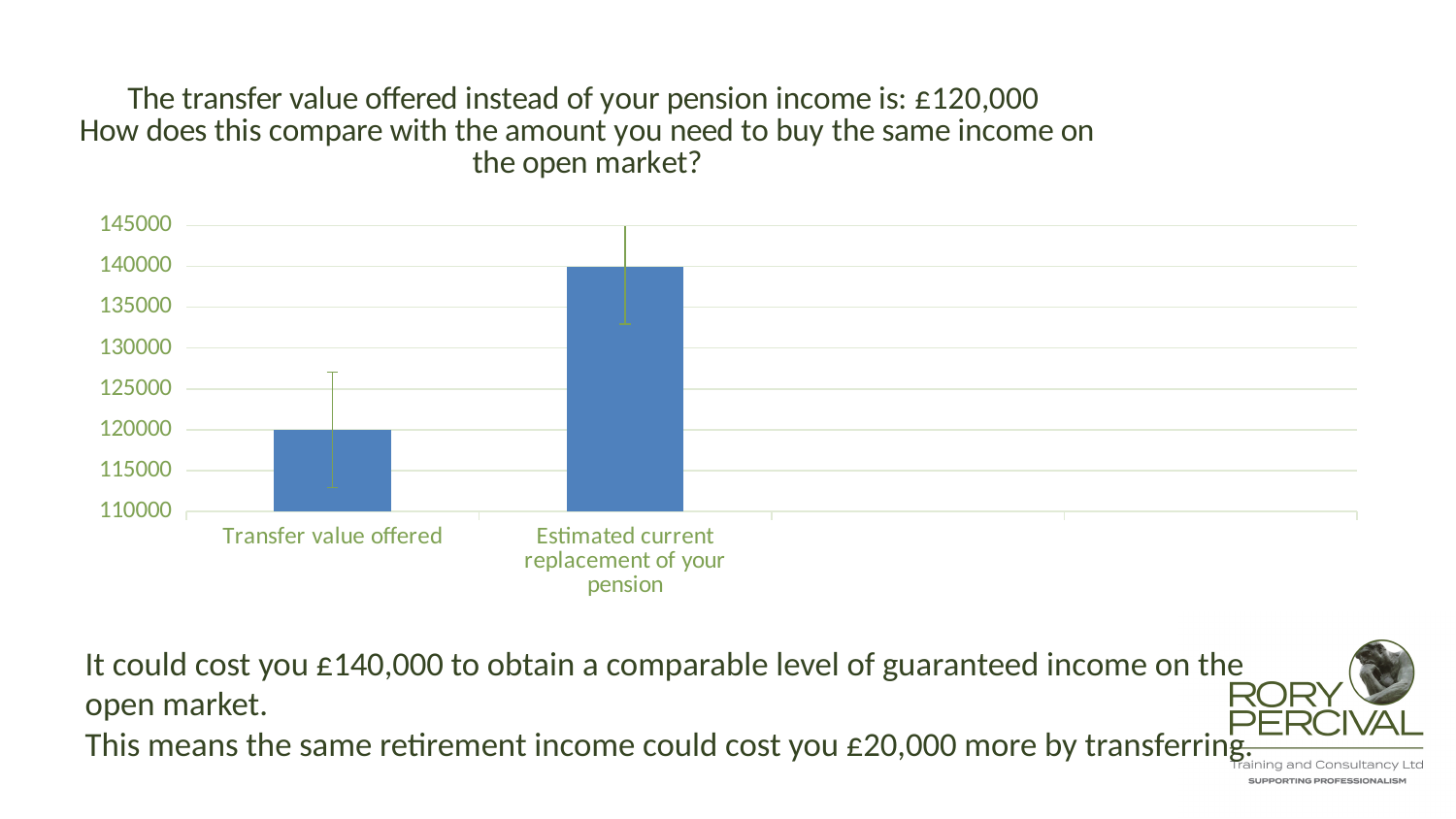
What is the difference between the 'Estimated current replacement of your pension' bar and the 'Transfer value offered' bar? 20000 What is the value of the 'Transfer value offered' bar? 120000 How many bars are plotted in the chart? 2 Is the value for 'Estimated current replacement of your pension' greater or less than 130000? greater Which category has the higher bar? Estimated current replacement of your pension Is the value for 'Transfer value offered' greater or less than 130000? less Is the 'Transfer value offered' bar larger or smaller than the 'Estimated current replacement of your pension' bar? smaller What kind of chart is shown on the slide? bar chart Which category has the lower bar? Transfer value offered What is the lowest value shown on the chart's vertical axis? 110000 Do the bar values rise or fall from left to right along the x axis? rise What is the value of the 'Estimated current replacement of your pension' bar? 140000